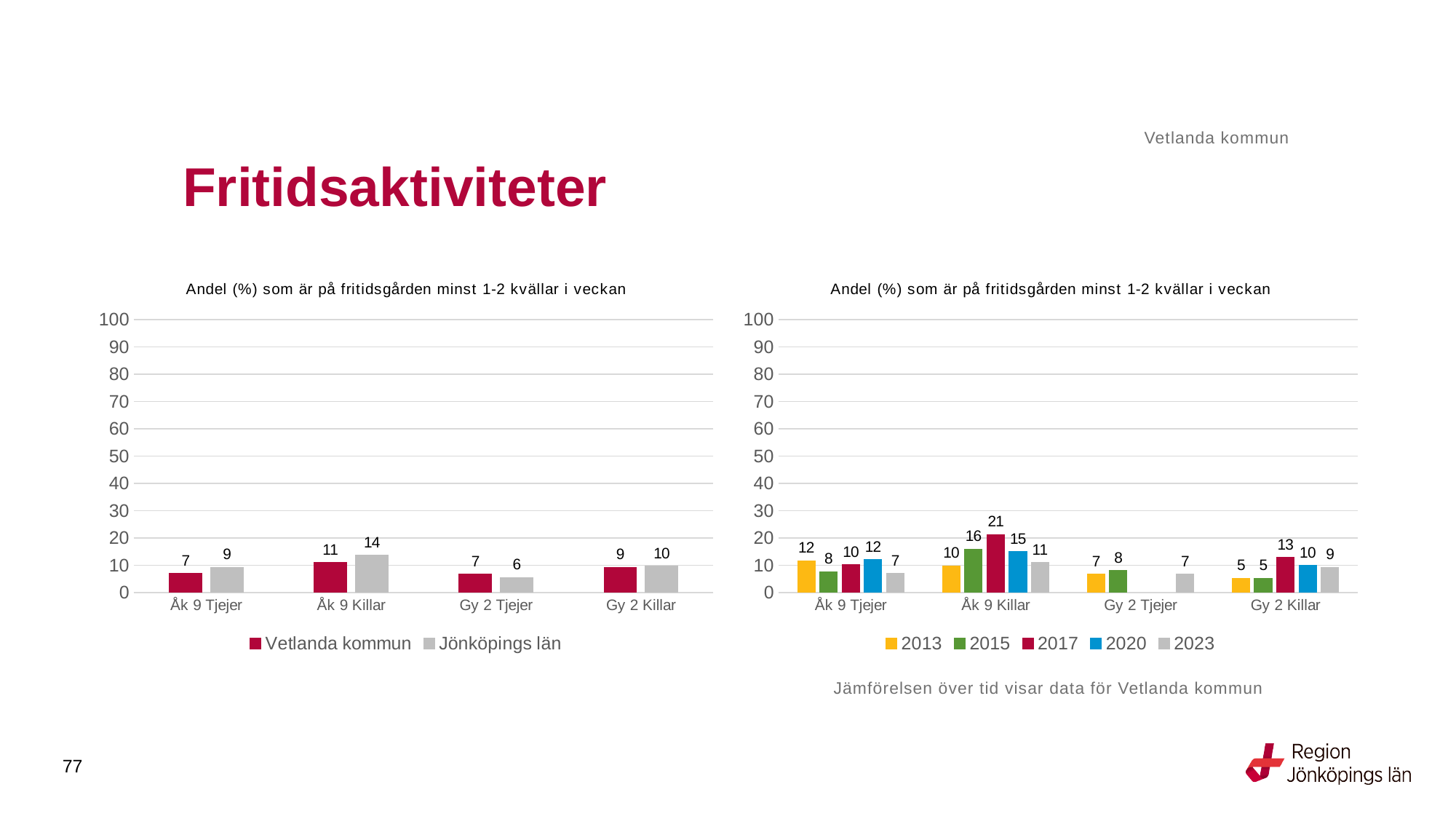
How many series does the legend of the left chart list? 2 In the left chart, which category has the highest value for Jönköpings län? Åk 9 Killar In the right chart, what is the value for 2017 for Åk 9 Killar? 21 In the right chart, what is the value for 2023 for Gy 2 Killar? 9 In the left chart, what is the value for Vetlanda kommun for Åk 9 Killar? 11 In the left chart, what is the value for Jönköpings län for Gy 2 Tjejer? 6 How many series does the legend of the right chart list? 5 What type of chart is the right chart? Bar chart In the right chart, which year has the lowest value for Åk 9 Tjejer? 2023 In the right chart, what is the difference between 2017 and 2013 for Gy 2 Killar? 8 In the left chart, what is the difference between Jönköpings län and Vetlanda kommun for Åk 9 Killar? 3 In the left chart, which is larger for Gy 2 Tjejer: Vetlanda kommun or Jönköpings län? Vetlanda kommun